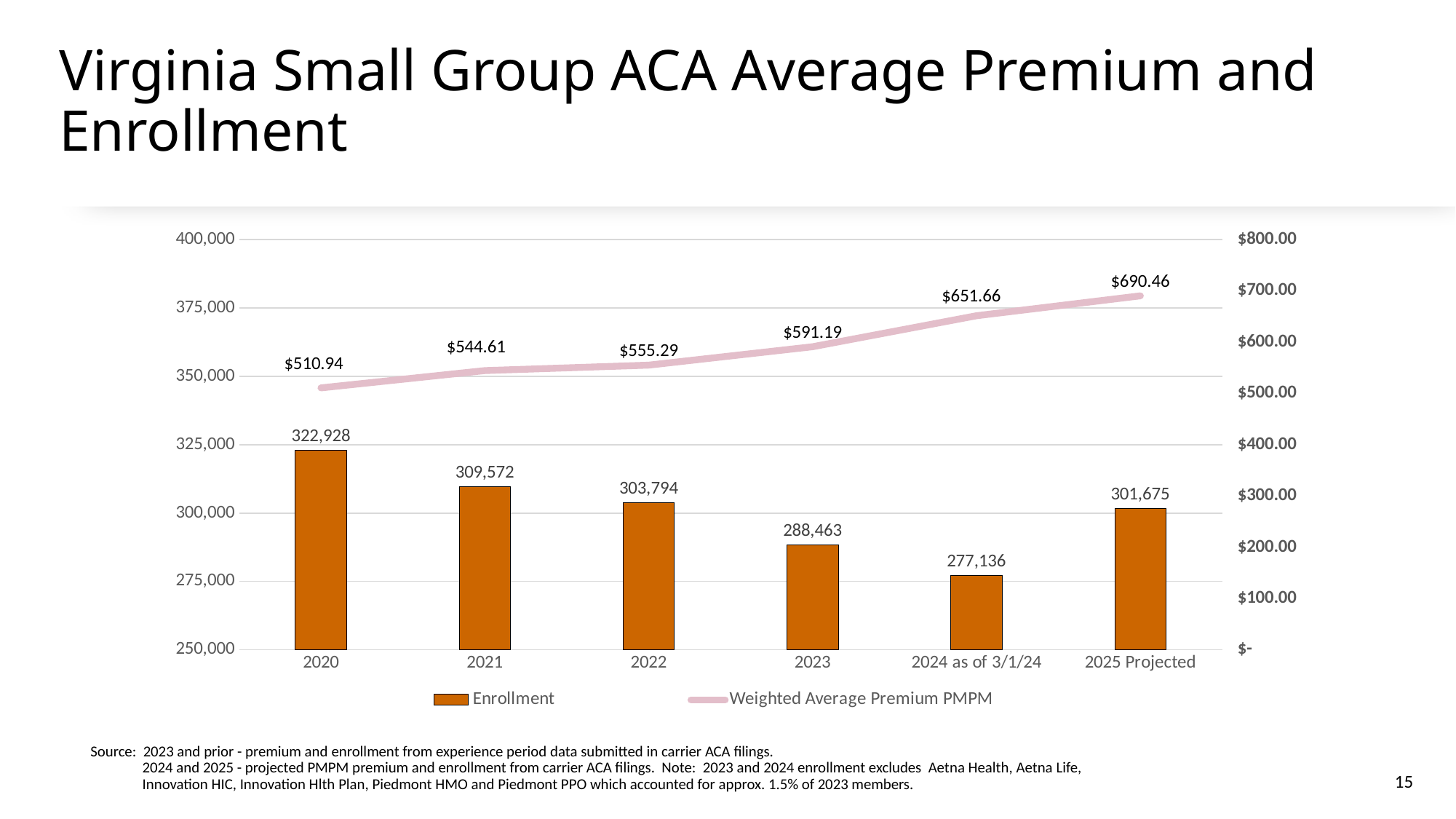
How many series does the legend list? 2 What is the Weighted Average Premium PMPM for 2022? $555.29 What is the difference in Weighted Average Premium PMPM between 2025 Projected and 2024 as of 3/1/24? $38.80 What is the Weighted Average Premium PMPM for 2025 Projected? $690.46 What is the Enrollment value for 2024 as of 3/1/24? 277,136 What is the difference in Enrollment between 2020 and 2021? 13,356 Which is larger, the Enrollment for 2022 or for 2025 Projected? 2022 How many categories are shown on the x axis? 6 Which year has the lowest Enrollment? 2024 as of 3/1/24 Which year has the highest Enrollment? 2020 Does the Weighted Average Premium PMPM rise or fall from 2020 to 2025 Projected? rise What is the Enrollment value for 2020? 322,928